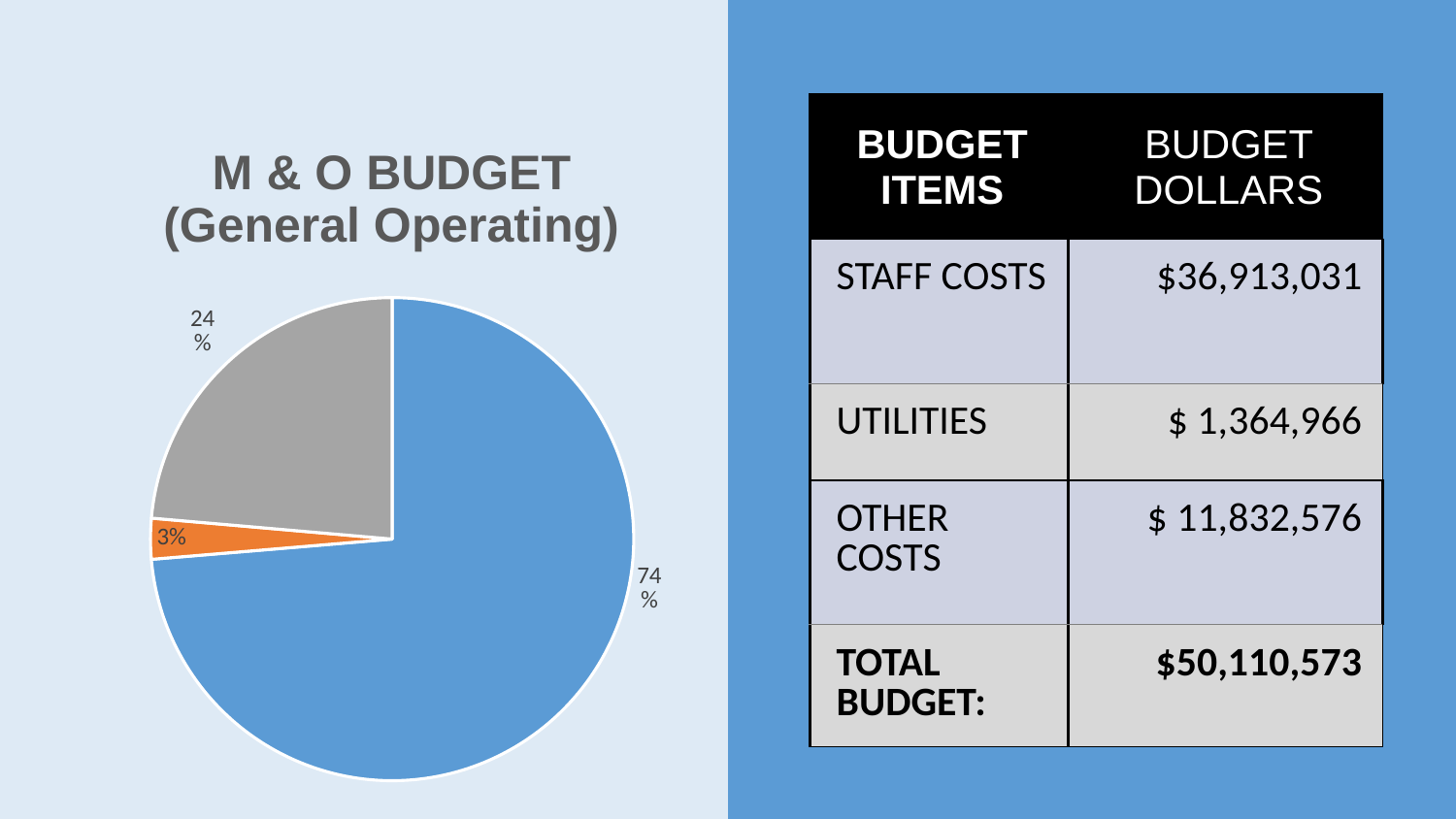
Which slice of the pie chart is the smallest? the orange slice (3%) Does the pie chart include a legend? No How many percentage points larger is the gray slice than the orange slice? 21 What percentage is shown for the gray slice of the pie chart? 24% What kind of chart is shown on the slide? pie chart Which is larger, the gray slice or the orange slice? the gray slice What percentage is shown for the blue slice of the pie chart? 74% Which slice of the pie chart is the largest? the blue slice (74%) What percentage is shown for the orange slice of the pie chart? 3% How many slices does the pie chart have? 3 What is the title of the pie chart? M & O BUDGET (General Operating) How many percentage points larger is the blue slice than the gray slice? 50